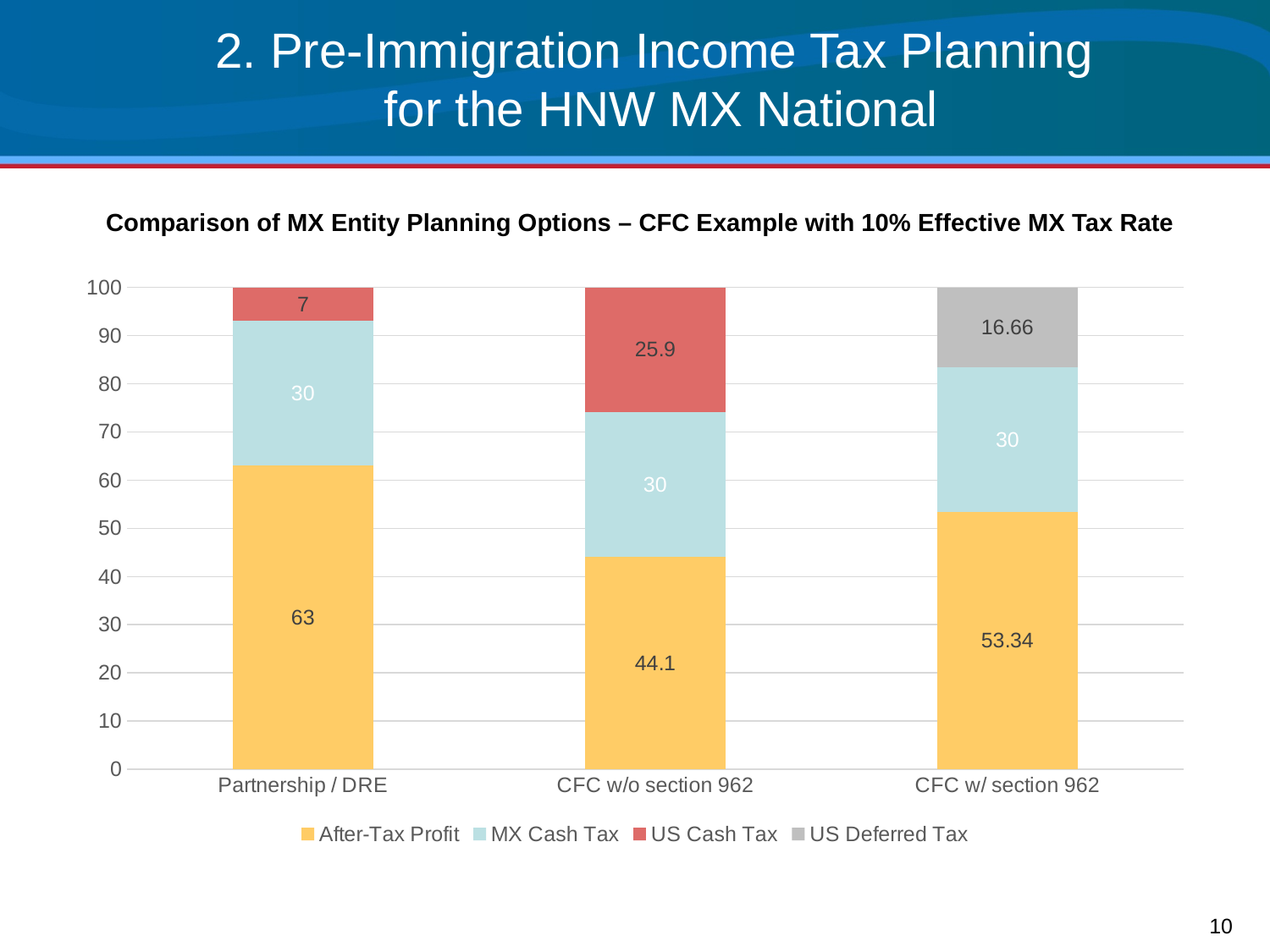
How many categories are shown on the x axis? 3 What is the difference in After-Tax Profit between Partnership / DRE and CFC w/ section 962? 9.66 What is the US Cash Tax value for CFC w/o section 962? 25.9 What kind of chart is shown? Stacked bar chart What is the MX Cash Tax value for CFC w/ section 962? 30 What is the After-Tax Profit value for Partnership / DRE? 63 Which category has the lowest After-Tax Profit? CFC w/o section 962 What is the US Deferred Tax value for CFC w/ section 962? 16.66 Which is larger: the US Cash Tax for Partnership / DRE or for CFC w/o section 962? CFC w/o section 962 Which category has the highest After-Tax Profit? Partnership / DRE What is the total of the stacked bar for CFC w/o section 962? 100 How many series does the legend list? 4